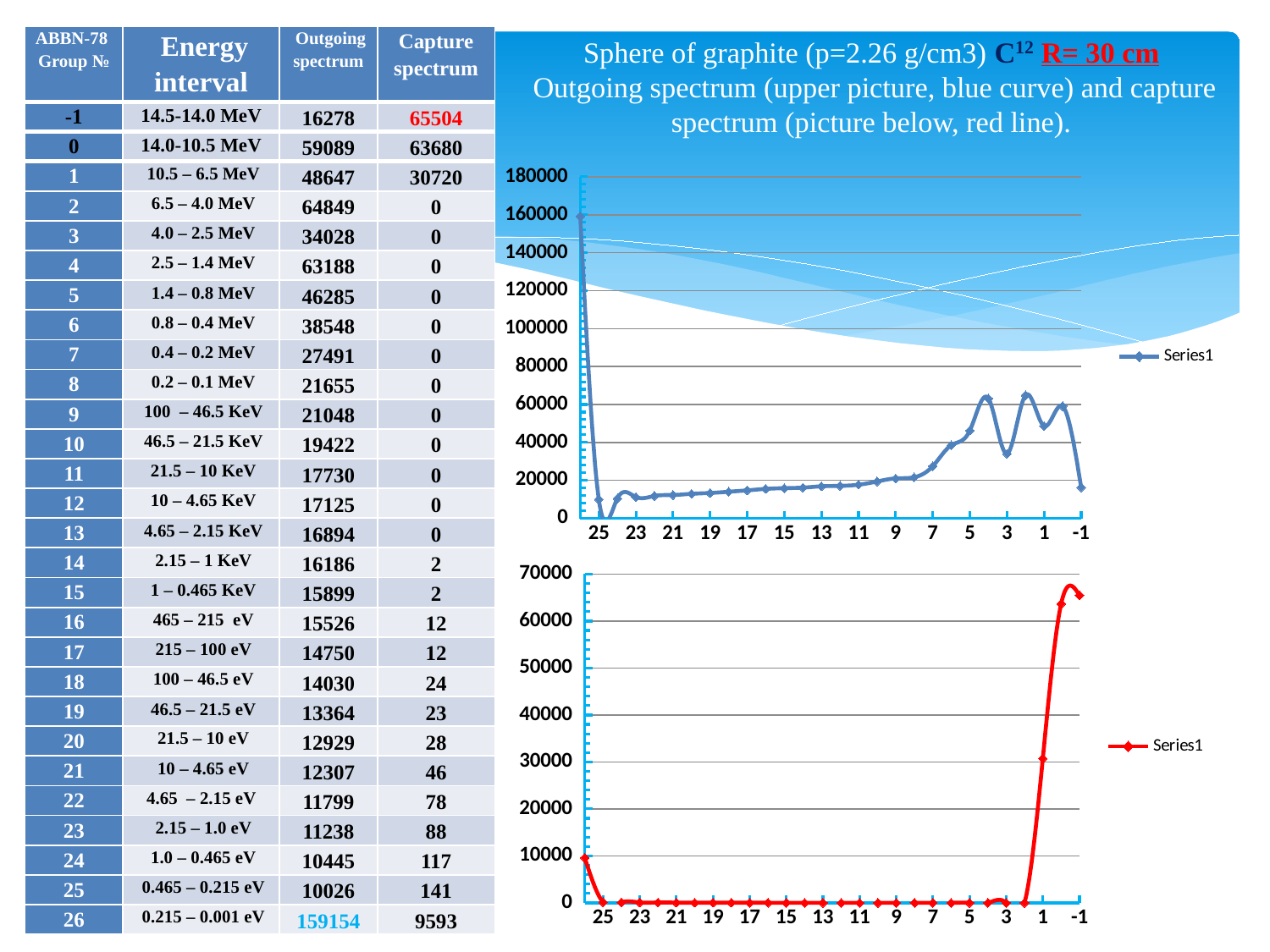
What is the legend entry shown for the lower chart? Series1 How many series does the legend of the upper chart list? 1 In the lower chart, is the value at x = 25 greater or less than 10000? less In the upper chart, which is larger: the value at the leftmost point or the value at x = 25? the leftmost point What kind of chart is the lower chart on the slide? line chart In the upper chart, is the value at x = -1 greater or less than 20000? less What kind of chart is the upper chart on the slide? line chart In the upper chart, is the value at x = 25 greater or less than 20000? less What colour is the line in the lower chart? red